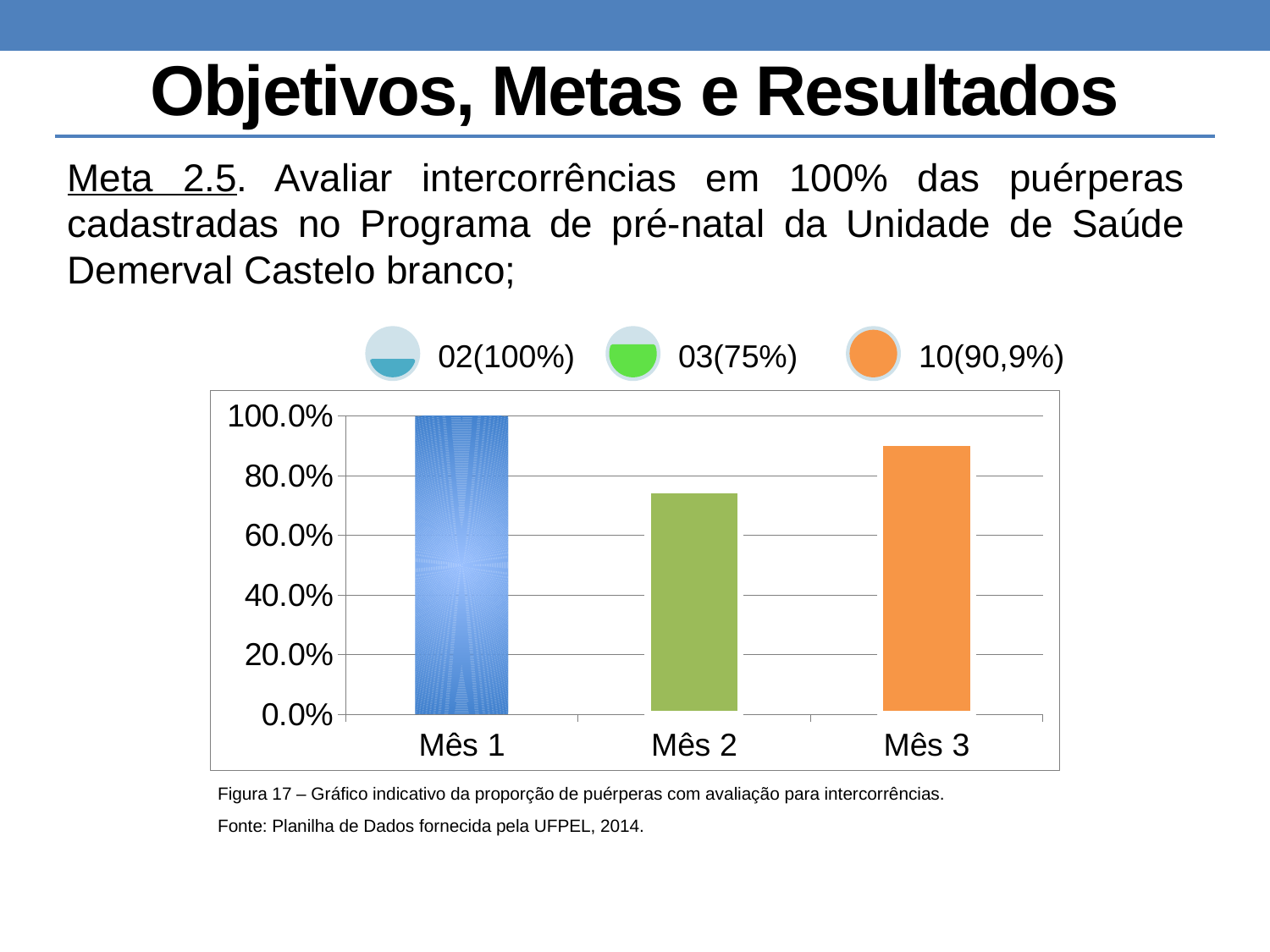
What is the value shown for Mês 1? 100% Which month has the lowest value? Mês 2 Does the value rise or fall from Mês 1 to Mês 2? fall What kind of chart is shown on the slide? bar chart What is the value shown for Mês 3? 90,9% What is the difference between the values for Mês 1 and Mês 2? 25% Which month has the highest value? Mês 1 Is the value for Mês 2 greater or less than 80.0%? less How many months are shown on the x axis? 3 Which is larger, the value for Mês 2 or the value for Mês 3? Mês 3 What is the value shown for Mês 2? 75% What figure number is given in the caption below the chart? Figura 17